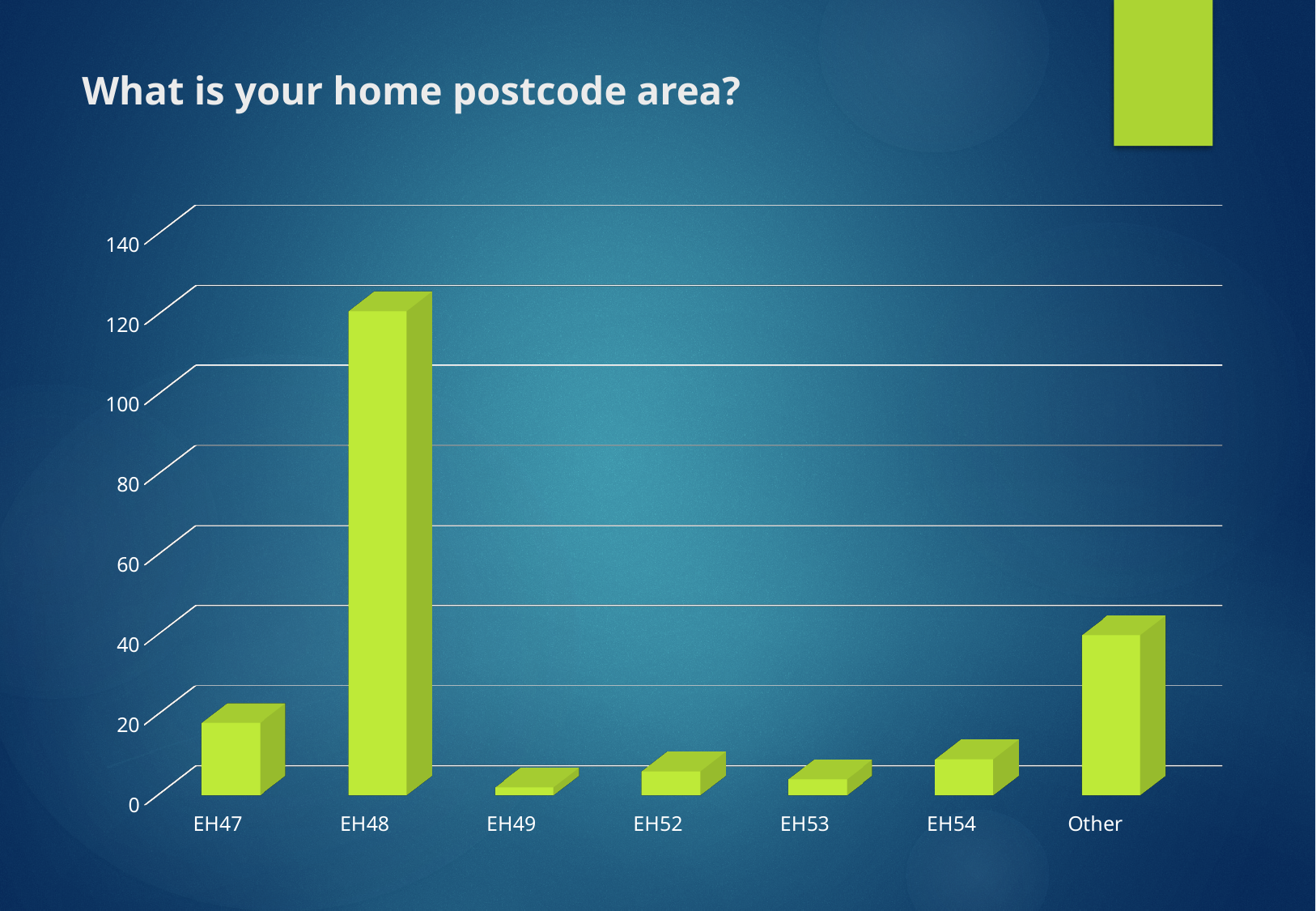
Which has the larger value, EH54 or EH49? EH54 What colour are the bars in the chart? green What kind of chart is shown on the slide? bar chart Is the value for Other greater or less than 60? less Which has the larger value, Other or EH47? Other Which has the larger value, EH48 or Other? EH48 Is the value for EH48 greater or less than 100? greater Is the value for EH47 greater or less than 40? less Which postcode area has the highest value? EH48 How many postcode categories are shown on the x axis? 7 What is the title of the chart? What is your home postcode area?